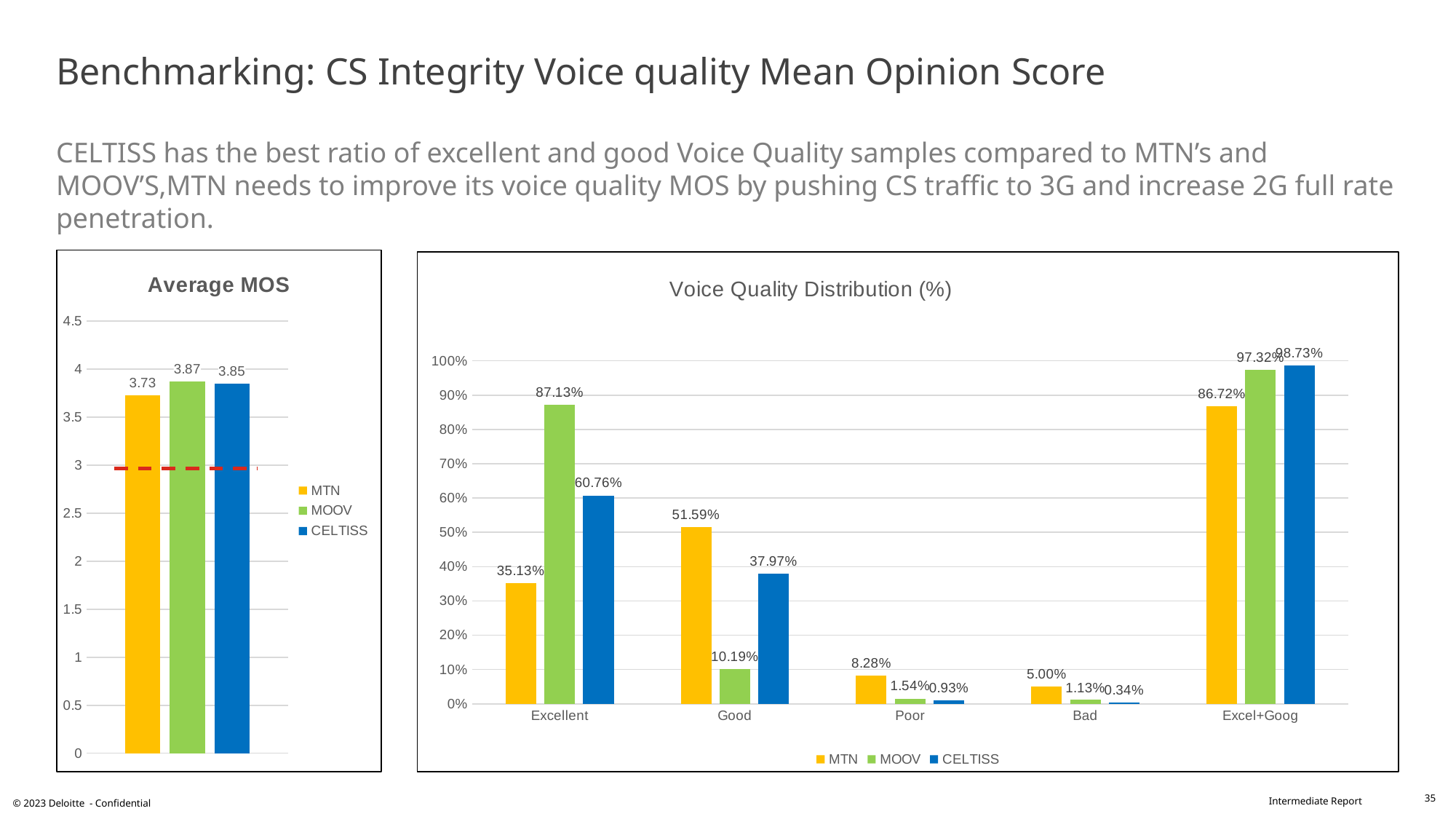
In the Voice Quality Distribution (%) chart, which operator has the lowest value in the Bad category? CELTISS In the Average MOS chart, what is the value for MTN? 3.73 In the Voice Quality Distribution (%) chart, how many categories are shown on the x axis? 5 In the Average MOS chart, which operator has the highest average MOS? MOOV In the Voice Quality Distribution (%) chart, what is the value for CELTISS in the Good category? 37.97% In the Voice Quality Distribution (%) chart, what is the difference between MTN's and MOOV's values in the Poor category? 6.74% In the Voice Quality Distribution (%) chart, which operator has the highest value in the Excel+Goog category? CELTISS In the Voice Quality Distribution (%) chart, which is larger: MTN's value for Good or CELTISS's value for Good? MTN's value for Good In the Voice Quality Distribution (%) chart, what is the value for MOOV in the Excellent category? 87.13% What kind of chart is the Voice Quality Distribution (%) chart? Bar chart In the Average MOS chart, what is the difference between MOOV's and MTN's values? 0.14 In the Average MOS chart, how many series does the legend list? 3